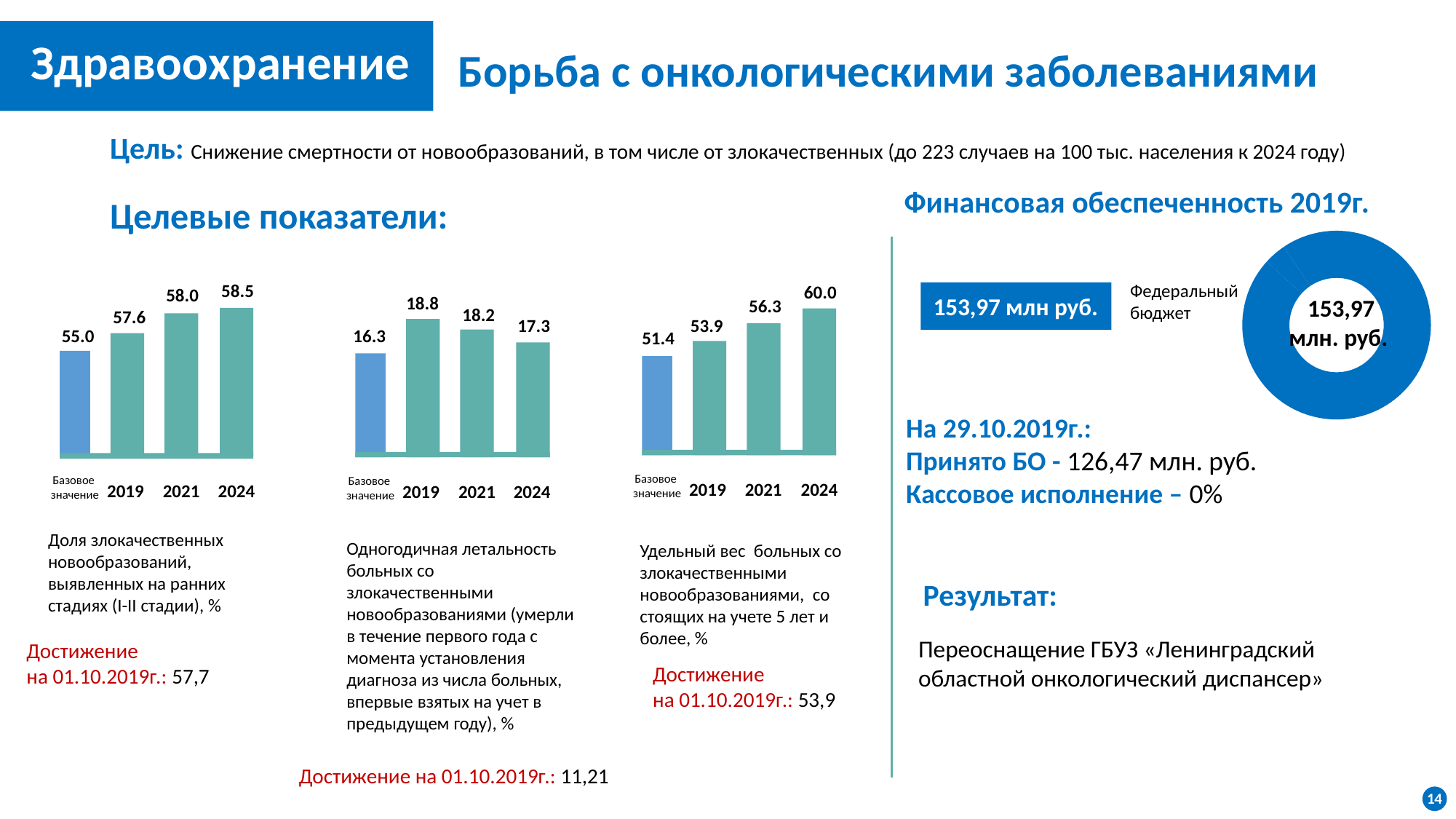
In the rightmost bar chart, do the values rise or fall from the base value to 2024? rise What kind of chart is shown under the heading 'Финансовая обеспеченность 2019г.'? donut (pie) chart In the middle bar chart, what is the difference between the 2019 value and the 2024 value? 1.5 In the rightmost bar chart (share of patients registered 5 years or more), what is the value for 2024? 60.0 In the leftmost bar chart (share of malignant neoplasms detected at early stages), what is the value for 2024? 58.5 In the rightmost bar chart, which category has the lowest value? Базовое значение In the middle bar chart, what is the value for 2021? 18.2 What value is printed in the centre of the donut chart on the right? 153,97 млн. руб. How many bars does the leftmost bar chart have? 4 In the middle bar chart (one-year lethality), which category has the highest value? 2019 In the leftmost bar chart, what is the base value (Базовое значение)? 55.0 In the rightmost bar chart, what is the difference between the 2024 value and the base value? 8.6